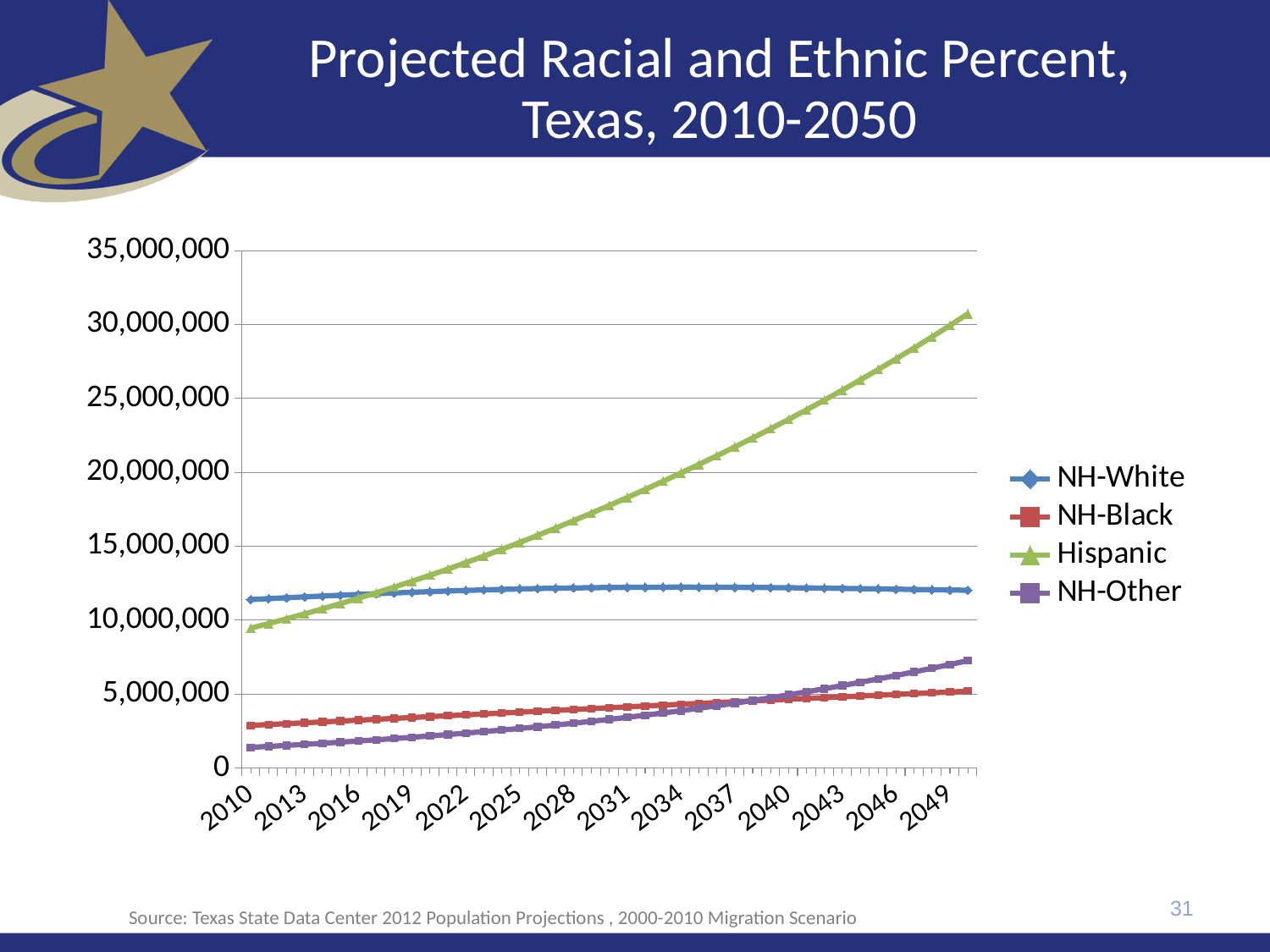
Which series has the highest value in 2049? Hispanic Is the Hispanic value in 2010 greater or less than 10,000,000? less In 2010, which is larger: NH-White or Hispanic? NH-White What kind of chart is shown on the slide? line chart In 2049, which is larger: NH-Black or NH-Other? NH-Other Does the Hispanic series rise or fall from 2010 to 2049? rise Which series has the lowest value in 2010? NH-Other Is the Hispanic value in 2049 greater or less than 25,000,000? greater Is the NH-Black value in 2010 greater or less than 5,000,000? less What is the title of the chart? Projected Racial and Ethnic Percent, Texas, 2010-2050 How many series does the legend list? 4 Which series is drawn in green? Hispanic